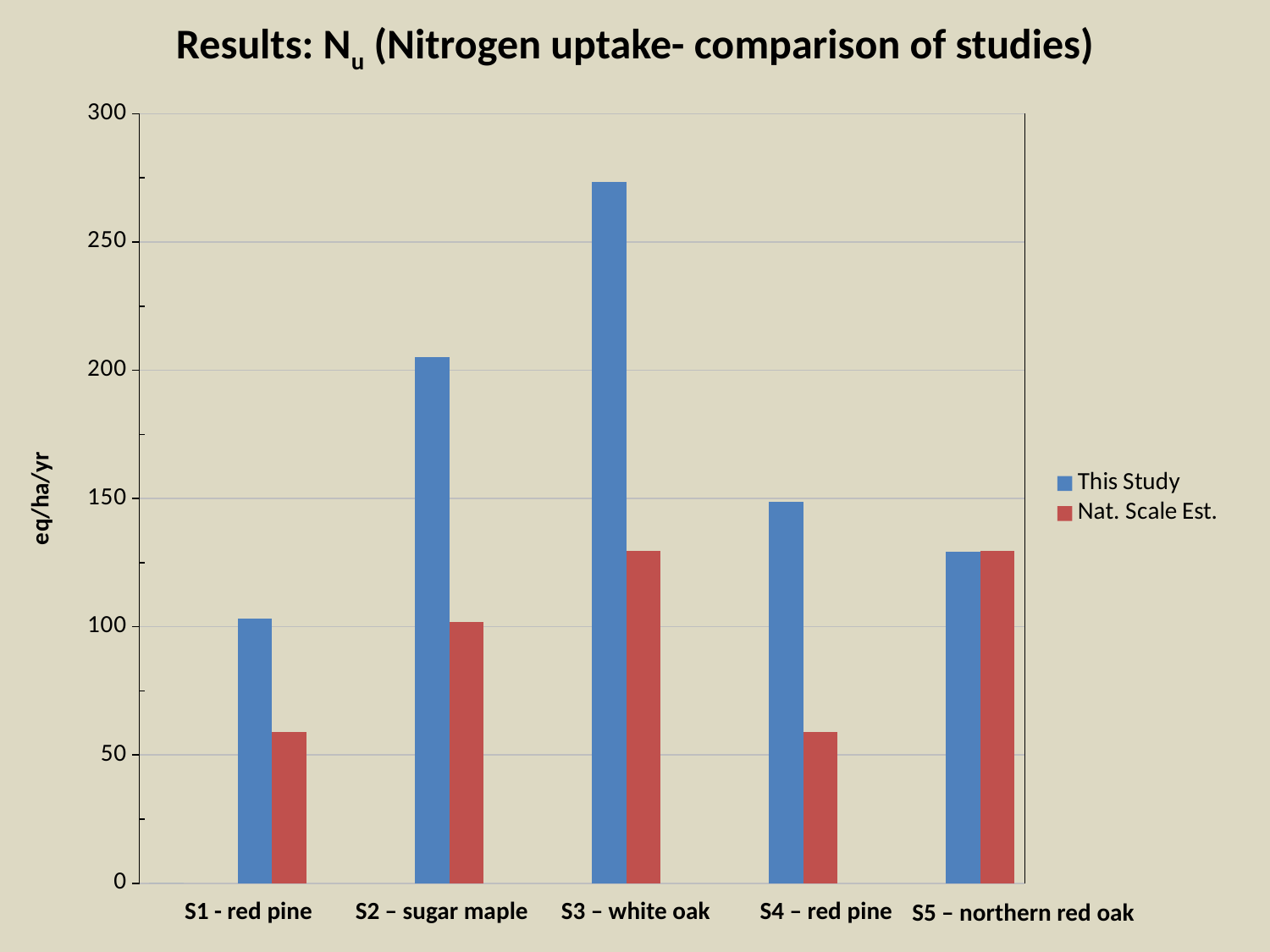
Which category has the highest value for This Study? S3 – white oak Which category has the lowest value for This Study? S1 - red pine Which has the larger This Study value, S2 – sugar maple or S4 – red pine? S2 – sugar maple What kind of chart is shown on the slide? bar chart Is the Nat. Scale Est. value for S1 - red pine greater or less than 100? less How many study categories are shown along the x axis? 5 Is the This Study value for S2 – sugar maple greater or less than 150? greater What is the label on the y axis? eq/ha/yr Is the This Study value for S3 – white oak greater or less than 250? greater For S2 – sugar maple, which series has the larger value, This Study or Nat. Scale Est.? This Study How many series does the legend list? 2